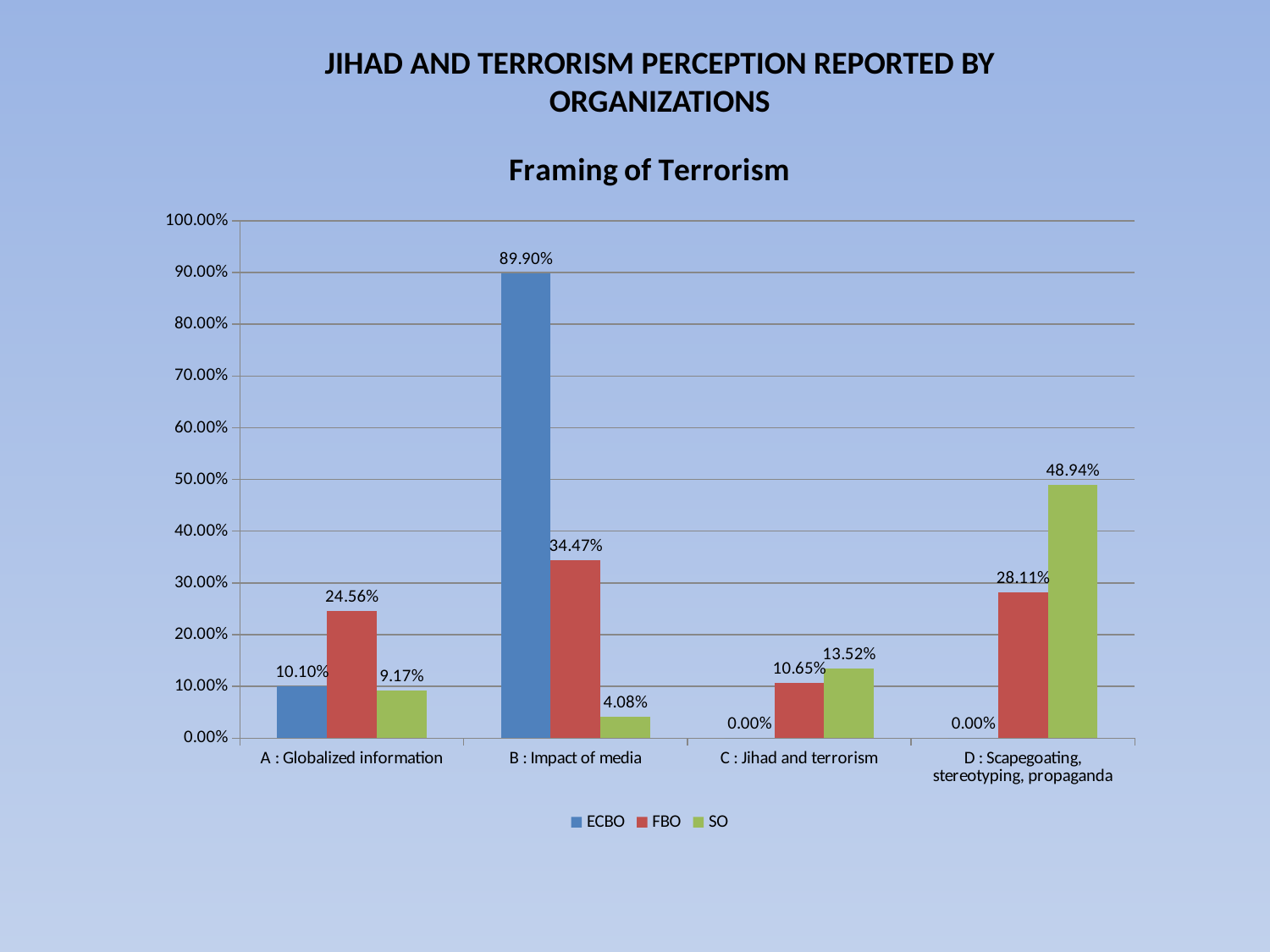
What is the ECBO value for C : Jihad and terrorism? 0.00% How many categories are shown on the x axis? 4 What is the title of the chart? Framing of Terrorism Which category has the highest FBO value? B : Impact of media What is the SO value for D : Scapegoating, stereotyping, propaganda? 48.94% Which category has the lowest SO value? B : Impact of media What is the ECBO value for B : Impact of media? 89.90% How many series does the legend list? 3 What is the difference between the SO and FBO values for D : Scapegoating, stereotyping, propaganda? 20.83% What is the FBO value for A : Globalized information? 24.56% What kind of chart is shown on the slide? Bar chart Which is larger for A : Globalized information, the ECBO value or the SO value? ECBO